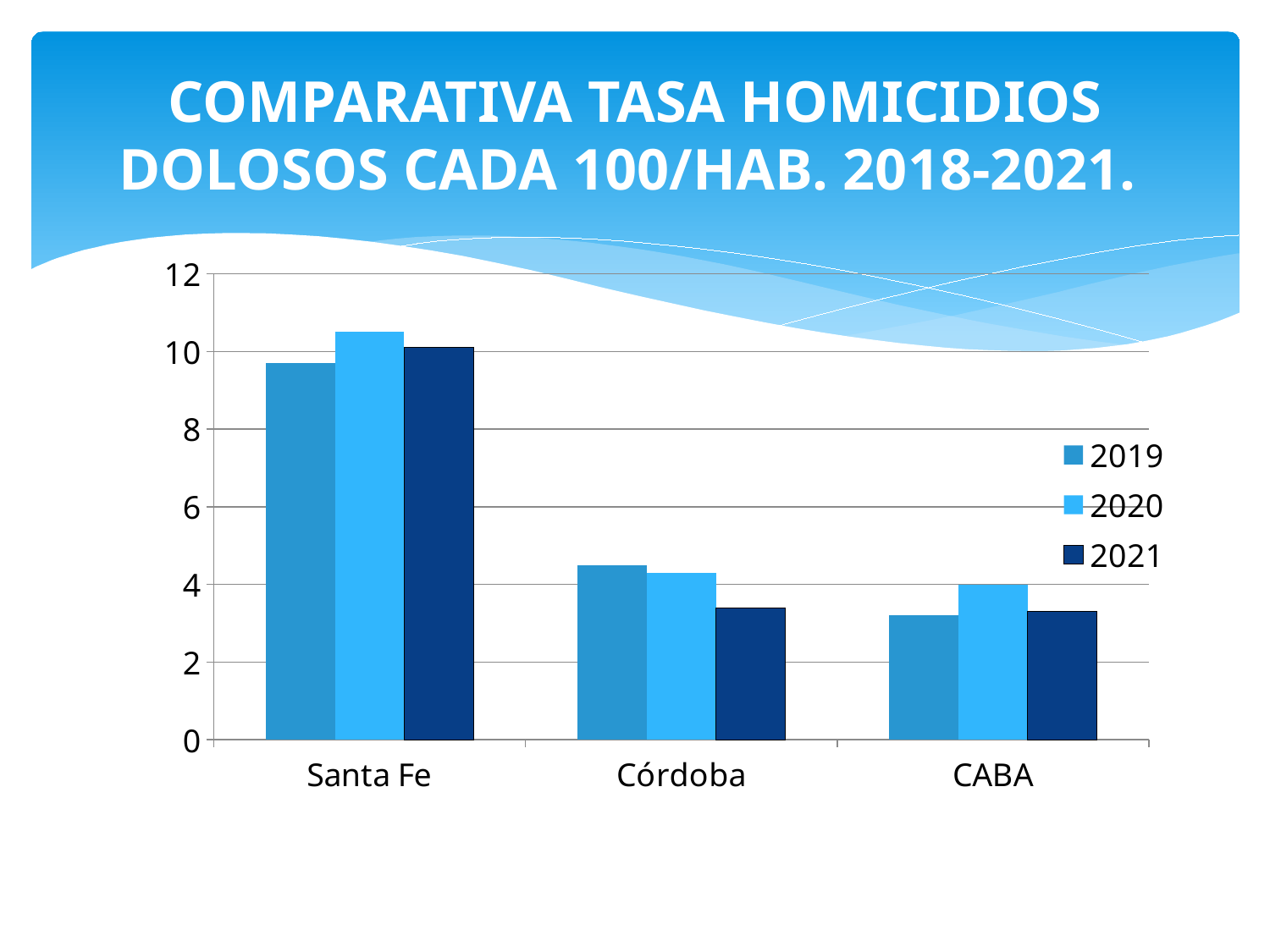
Is the value for Santa Fe in 2019 greater or less than 8? greater Which category has the lowest value for the 2019 series? CABA How many series does the legend list? 3 Is the value for Santa Fe in 2020 greater or less than 10? greater For Córdoba, which is larger: the 2019 value or the 2021 value? 2019 For Santa Fe, which is larger: the 2019 value or the 2020 value? 2020 How many categories are shown on the x axis? 3 What kind of chart is shown on the slide? bar chart Is the value for Córdoba in 2021 greater or less than 4? less Which category has the highest value for the 2020 series? Santa Fe What are the three entries listed in the legend? 2019, 2020, 2021